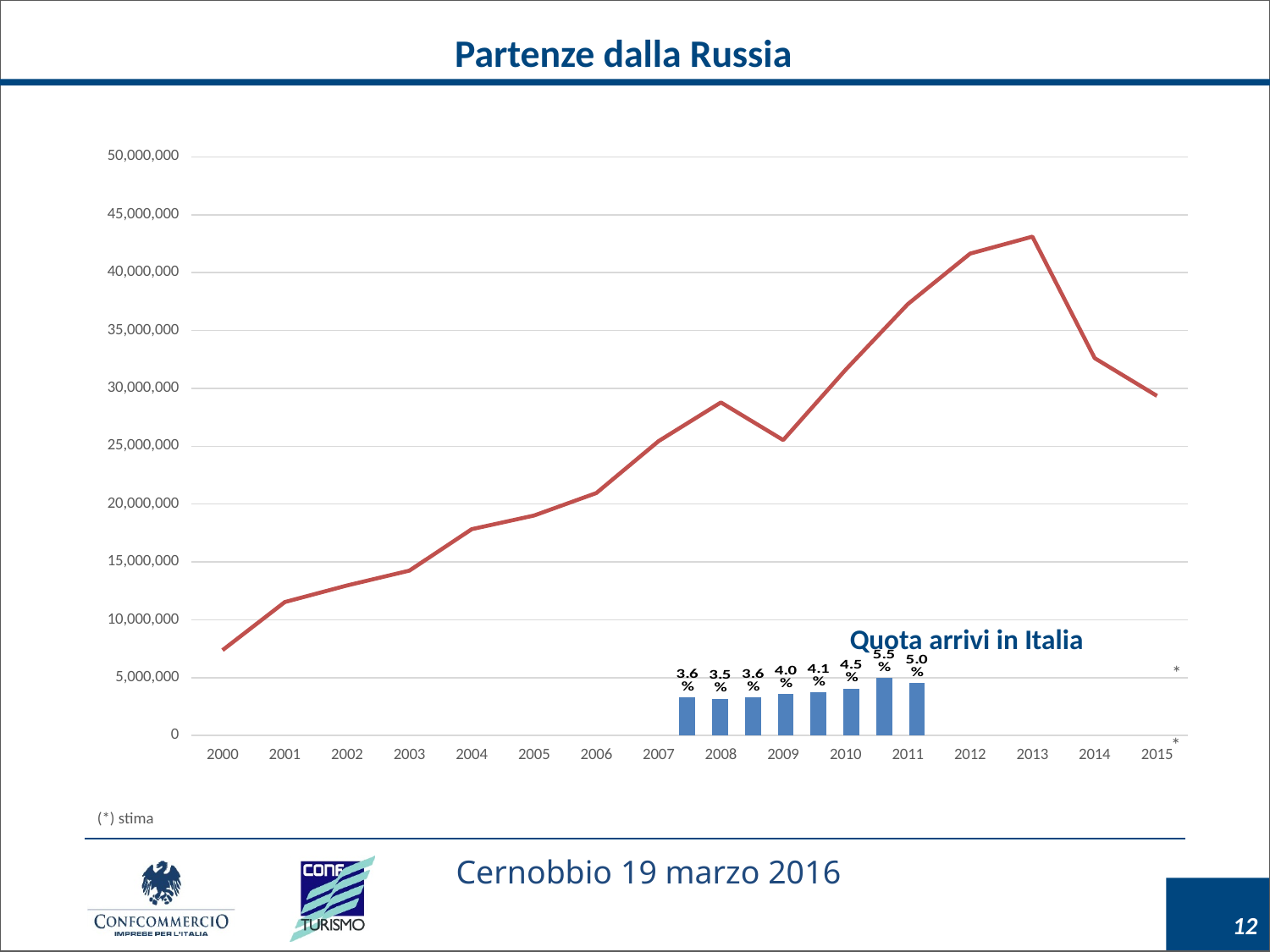
In the 'Partenze dalla Russia' line chart, do the values rise or fall from 2013 to 2015? fall In the 'Partenze dalla Russia' line chart, which year has the larger value, 2008 or 2009? 2008 How many years are shown on the x axis of the 'Partenze dalla Russia' line chart? 16 In the 'Partenze dalla Russia' line chart, is the value for 2004 greater or less than 15,000,000? greater In the 'Partenze dalla Russia' line chart, is the value for 2000 greater or less than 10,000,000? less In the 'Partenze dalla Russia' line chart, which year has the lowest value? 2000 In the 'Partenze dalla Russia' line chart, which year has the highest value? 2013 In the inset bar chart 'Quota arrivi in Italia', what is the highest value labelled on a bar? 5.5% In the 'Partenze dalla Russia' line chart, is the value for 2014 greater or less than 30,000,000? greater What kind of chart is the main chart on the slide, titled 'Partenze dalla Russia'? line chart What does the footnote on the slide say the asterisk (*) stands for? stima